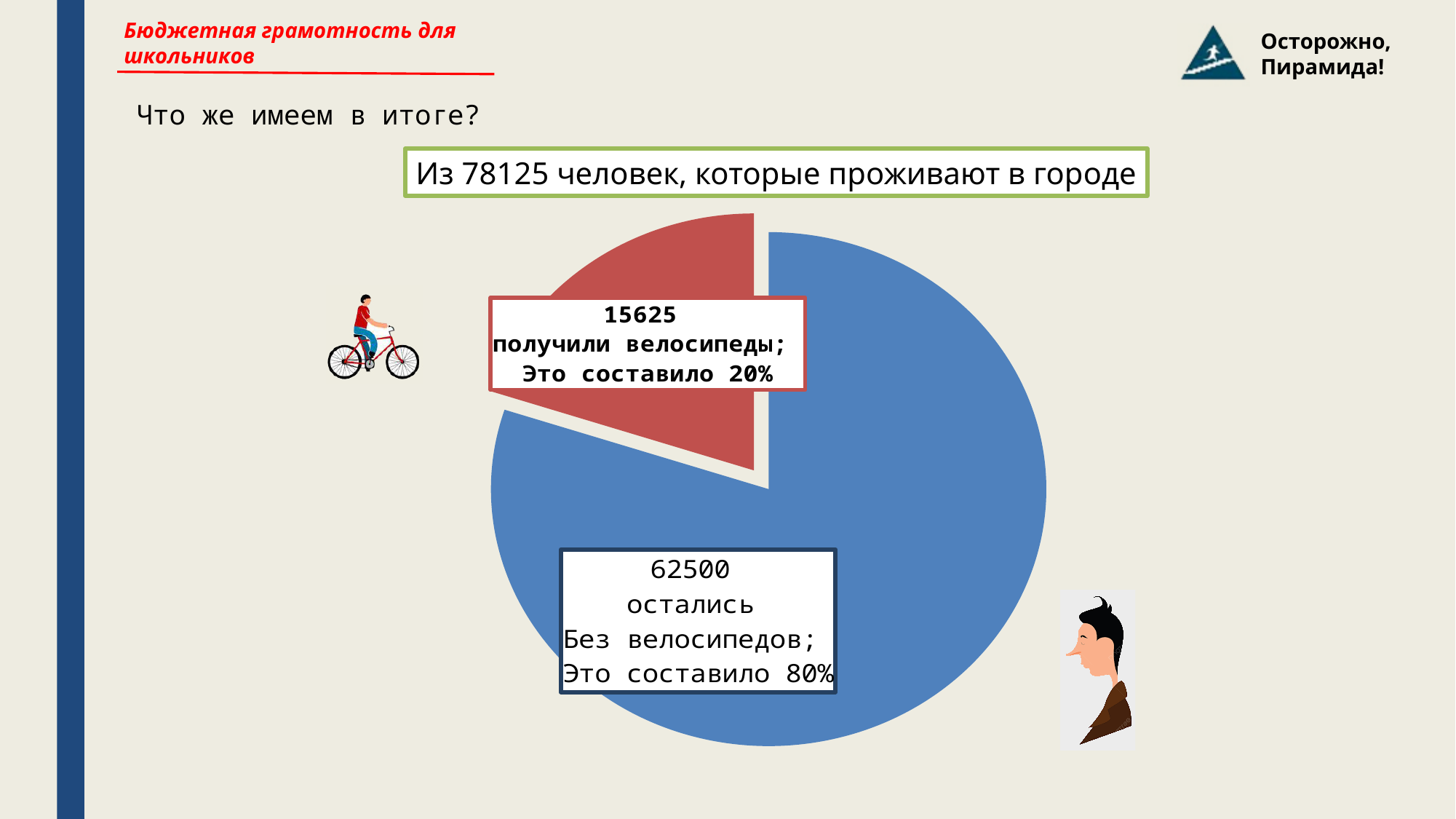
Which slice of the pie chart is the smallest? получили велосипеды (15625) What colour is the slice for people who received bicycles? red Which is larger: the number of people who received bicycles or the number who remained without bicycles? остались без велосипедов What is the total number of people represented by the two slices of the pie chart? 78125 What share of the pie does the slice for people who received bicycles represent? 20% How many people remained without bicycles (остались без велосипедов) according to the pie chart? 62500 What kind of chart is shown on the slide? pie chart How many people received bicycles (получили велосипеды) according to the pie chart? 15625 What share of the pie does the slice for people who remained without bicycles represent? 80% What is the difference between the number of people without bicycles and the number who received bicycles? 46875 Which slice of the pie chart is the largest? остались без велосипедов (62500) How many slices does the pie chart have? 2